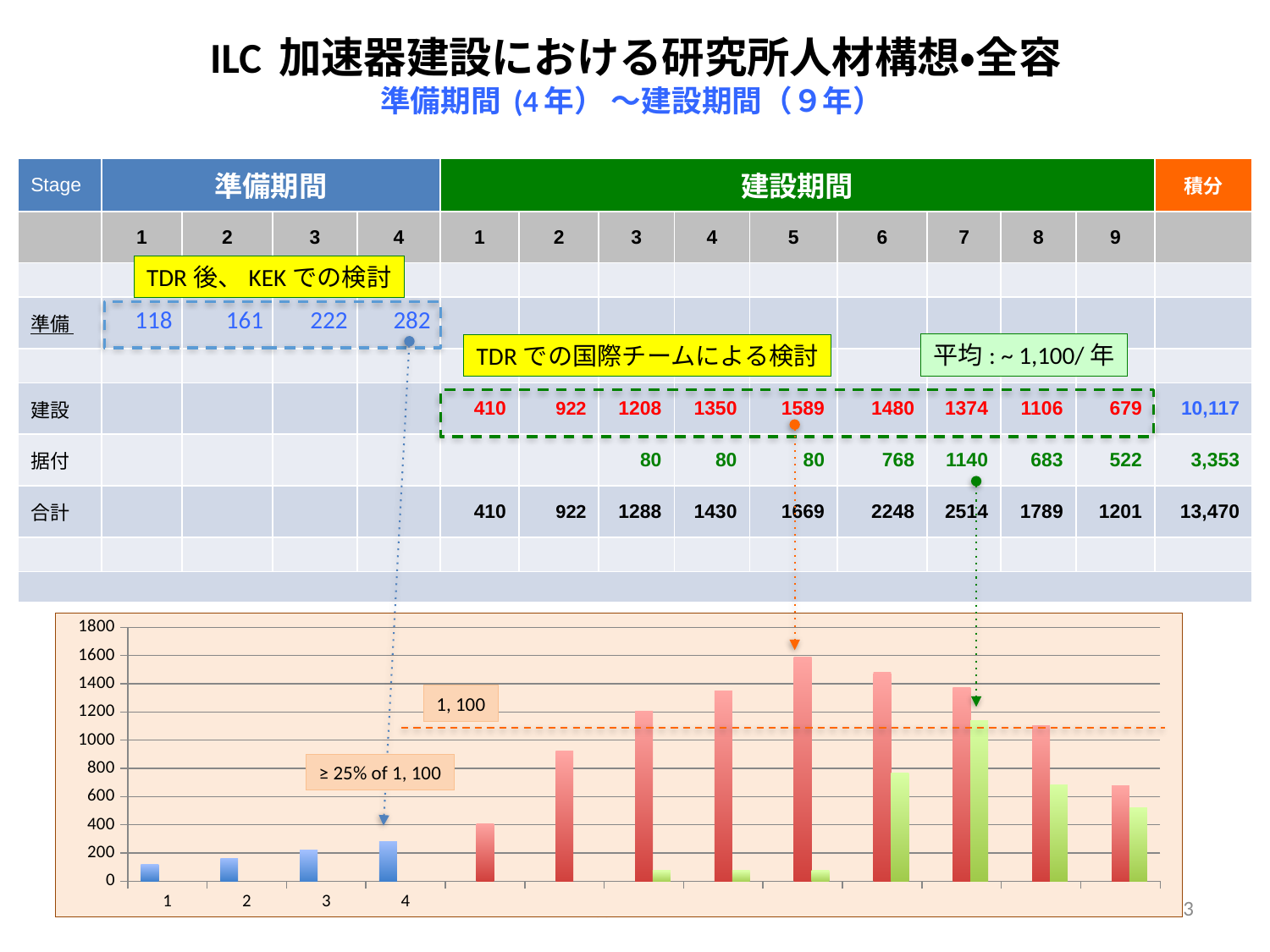
What value is labelled on the dashed horizontal line in the chart? 1, 100 Is the value of the blue bar for category 1 greater or less than 200? less What is the highest tick value shown on the chart's vertical axis? 1800 What kind of chart is shown at the bottom of the slide? bar chart How many red bars are plotted in the chart? 9 Is the value of the blue bar for category 4 greater or less than 200? greater How many blue bars are plotted in the chart? 4 Is the value of the tallest red bar greater or less than 1400? greater Which is taller, the tallest red bar or the tallest green bar? the tallest red bar Do the blue bars rise or fall from category 1 to category 4? rise How many green bars are plotted in the chart? 7